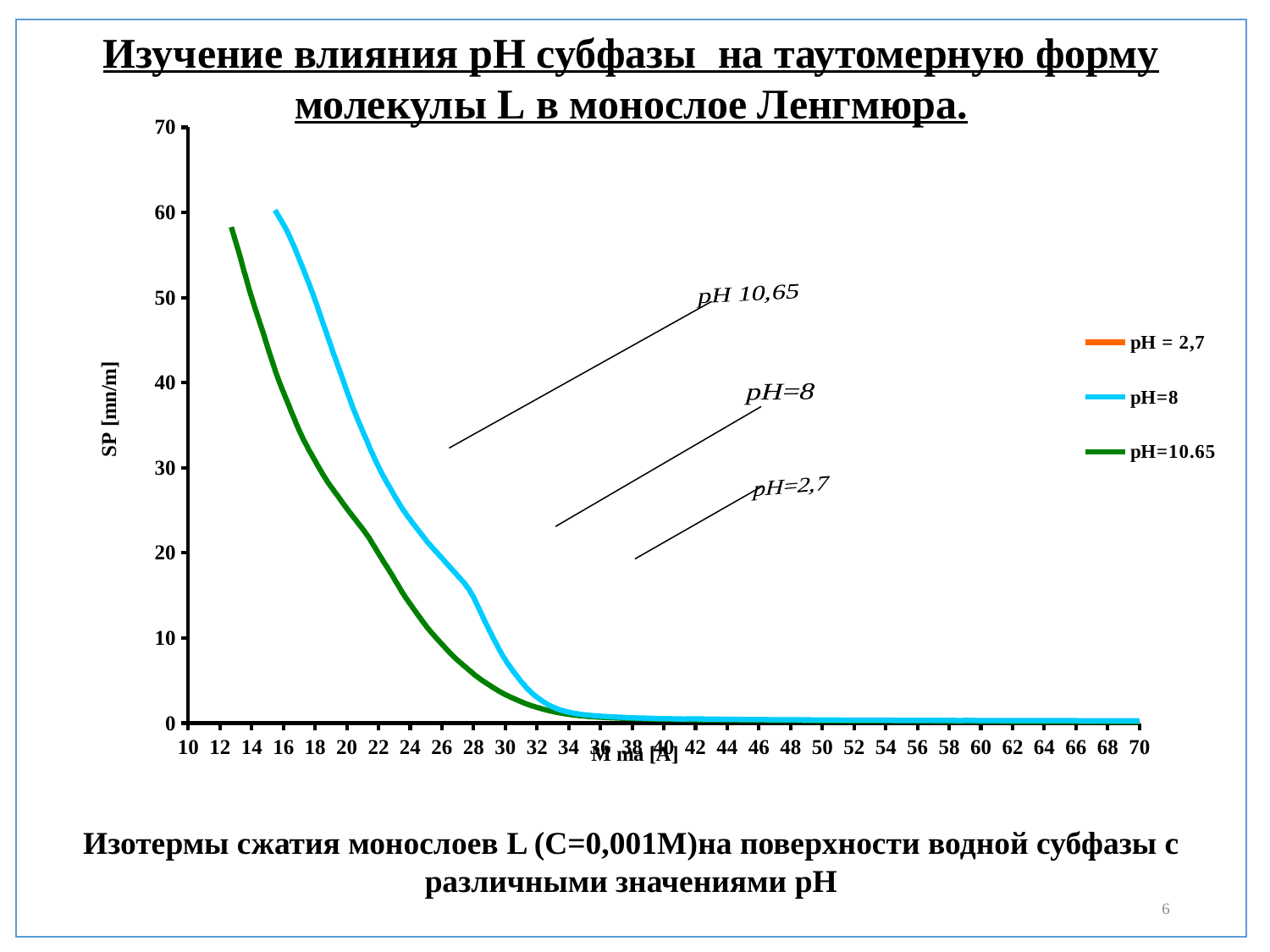
Is the value of the pH=10.65 curve at x = 24 greater or less than 20? less At x = 20, which curve is higher, pH=8 or pH=10.65? pH=8 What is the highest tick value shown on the y-axis? 70 What are the three series named in the legend? pH = 2,7, pH=8, pH=10.65 Is the value of the pH=8 curve at x = 18 greater or less than 40? greater What kind of chart is shown on the slide? line chart Do the curves rise or fall as the x-axis value increases? fall What colour is the pH=10.65 line in the legend? green Is the value of the pH=8 curve at x = 40 greater or less than 10? less How many series does the legend list? 3